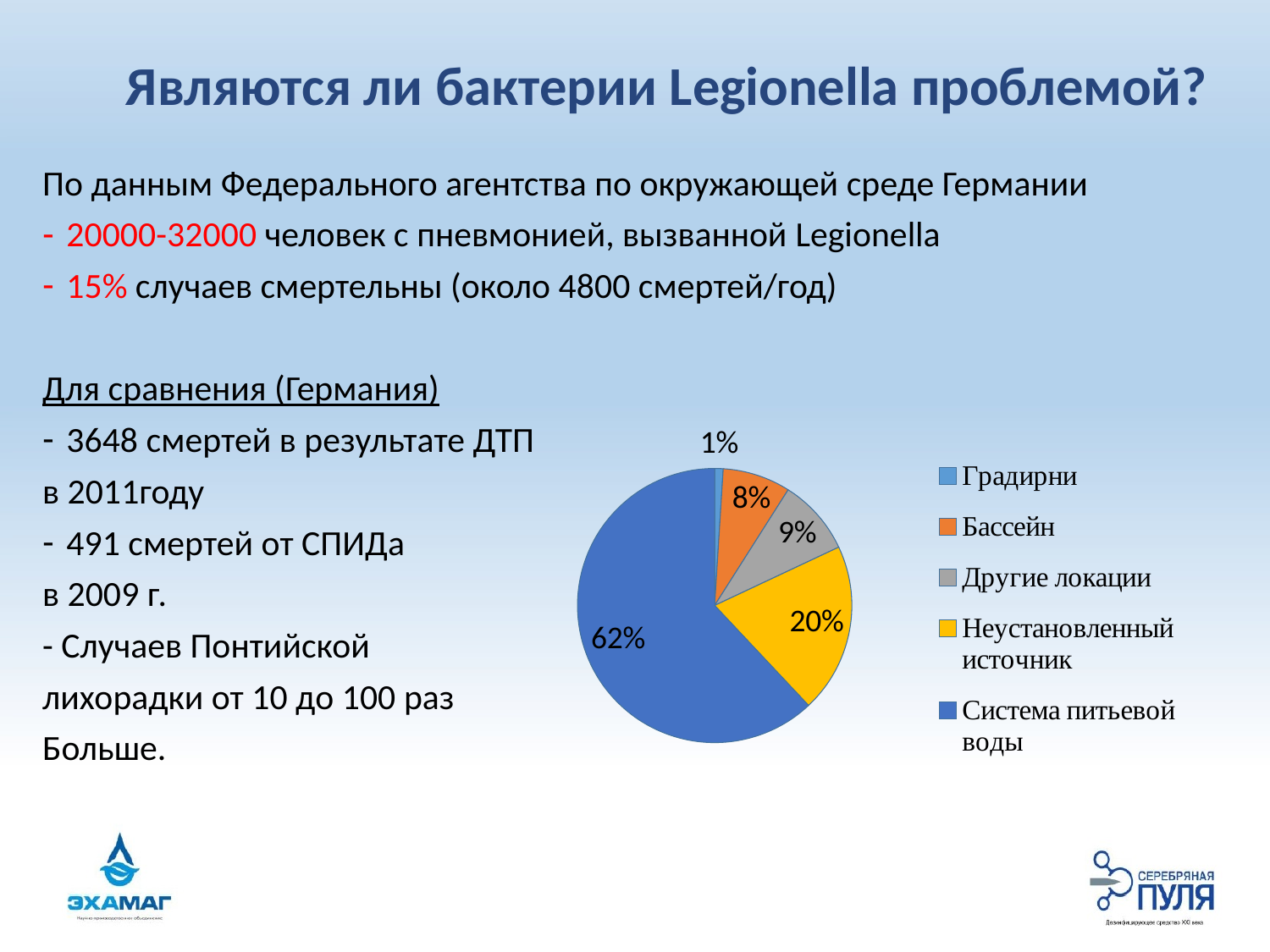
How many categories does the legend of the pie chart list? 5 Which category has the largest slice of the pie? Система питьевой воды Which category has the smallest slice of the pie? Градирни Which is larger, the share for "Другие локации" or the share for "Бассейн"? Другие локации What is the value shown for "Бассейн"? 8% What is the value shown for "Неустановленный источник"? 20% What share of the pie does "Система питьевой воды" account for? 62% What is the value shown for "Другие локации"? 9% What colour is the slice for "Неустановленный источник"? yellow What is the value shown for "Градирни"? 1% What is the difference between the shares of "Система питьевой воды" and "Неустановленный источник"? 42% What kind of chart is shown on the slide? pie chart